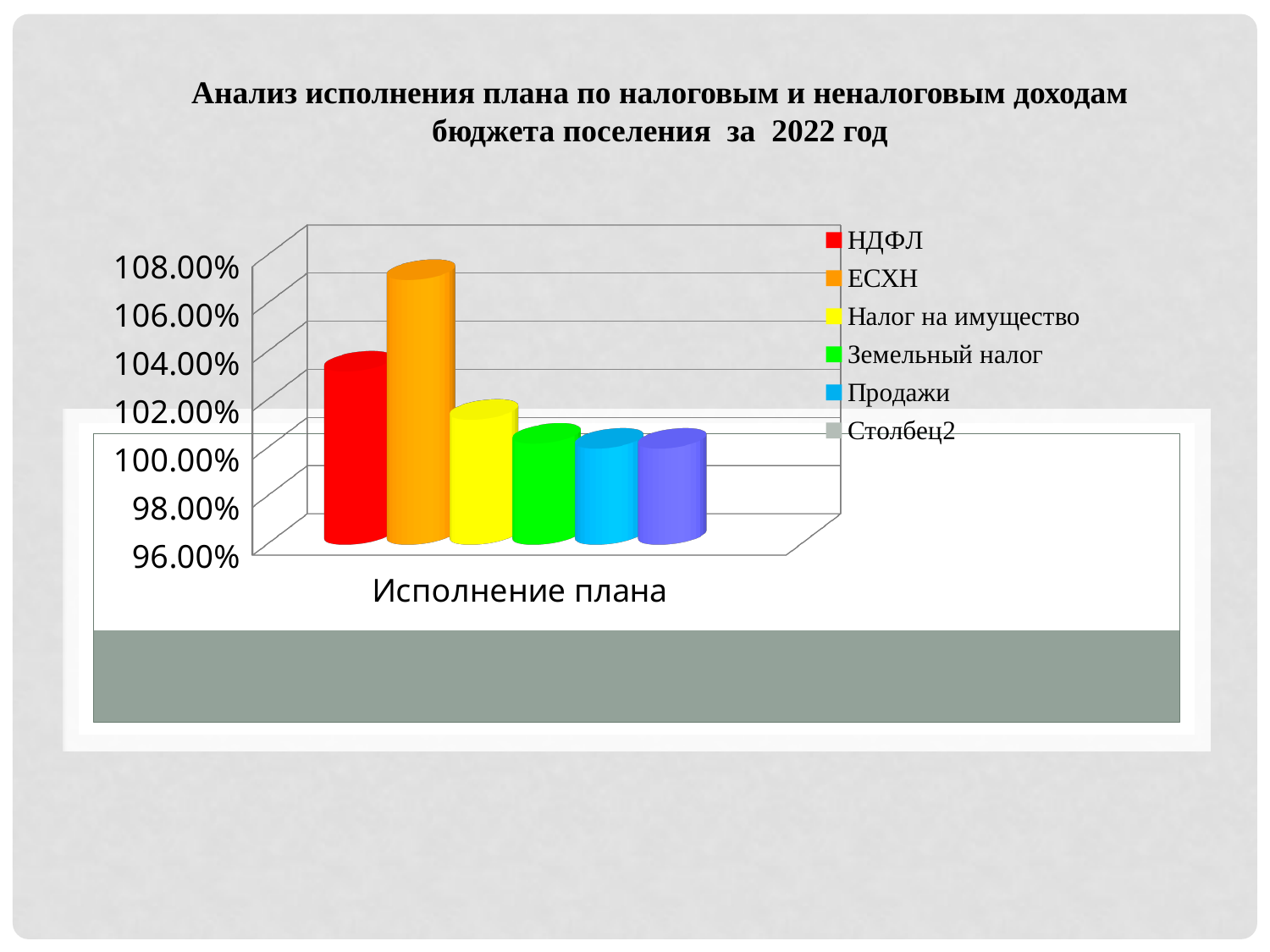
Is the value for НДФЛ greater or less than 102.00%? greater Which series is shown in red in the legend? НДФЛ What kind of chart is shown on the slide? bar chart What is the category label shown on the x axis? Исполнение плана How many categories are shown on the x axis? 1 Is the value for Земельный налог greater or less than 104.00%? less Is the value for ЕСХН greater or less than 106.00%? greater Which series has the highest value for Исполнение плана? ЕСХН How many series does the legend list? 6 Which is larger, the value for НДФЛ or the value for Земельный налог? НДФЛ Which is larger, the value for ЕСХН or the value for НДФЛ? ЕСХН